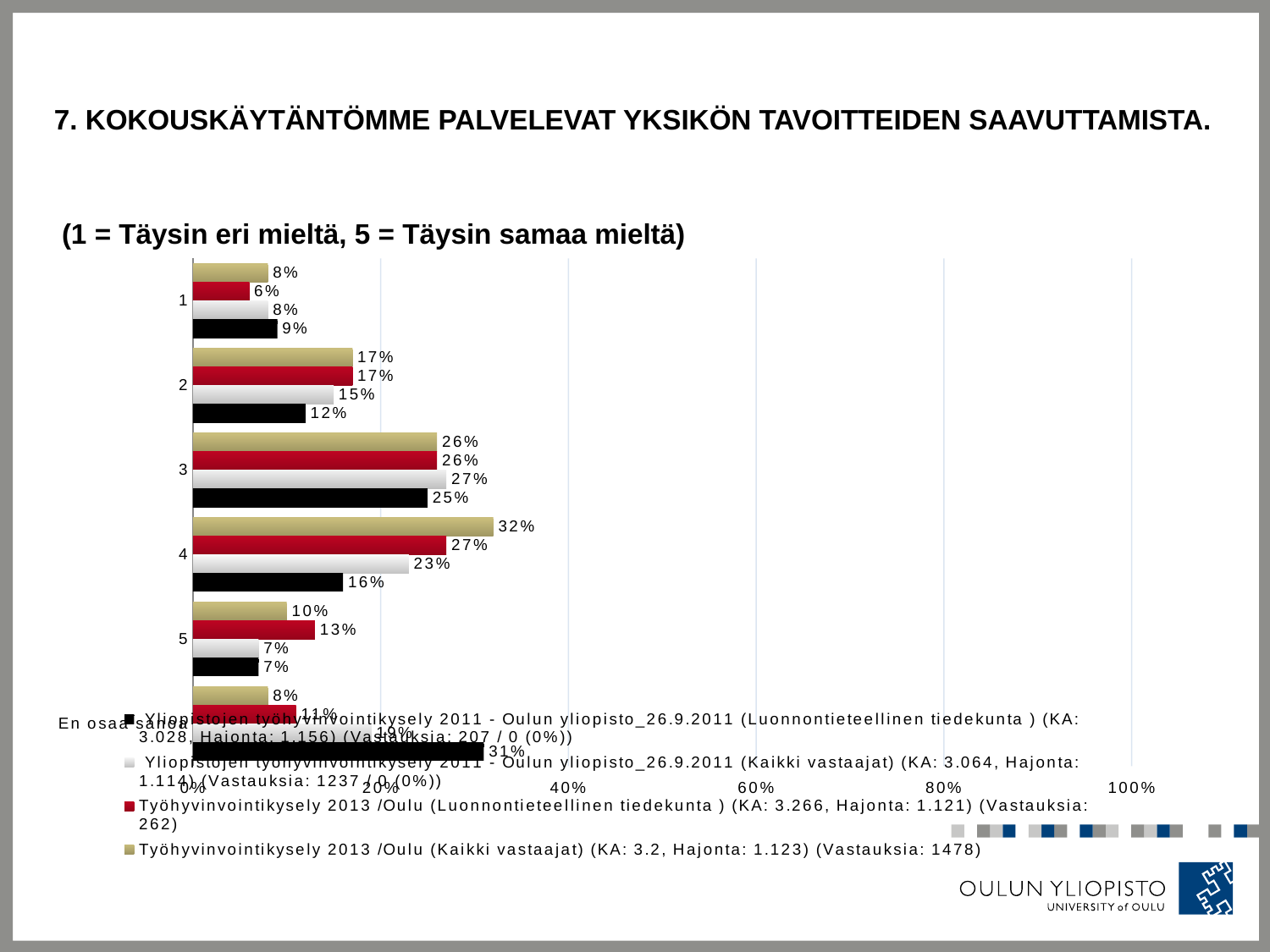
What is the value for category 4 in the Työhyvinvointikysely 2013 /Oulu (Kaikki vastaajat) series? 32% What is the value for category 5 in the Työhyvinvointikysely 2013 /Oulu (Luonnontieteellinen tiedekunta) series? 13% Is the value for category 4 in the Työhyvinvointikysely 2013 /Oulu (Kaikki vastaajat) series greater or less than 20%? greater What is the value for 'En osaa sanoa' in the Yliopistojen työhyvinvointikysely 2011 (Luonnontieteellinen tiedekunta) series? 31% What is the value for category 3 in the Yliopistojen työhyvinvointikysely 2011 (Kaikki vastaajat) series? 27% How many series does the legend list? 4 How many categories are shown on the vertical axis of the chart? 6 What kind of chart is shown on the slide? bar chart What is the difference between the Työhyvinvointikysely 2013 /Oulu (Kaikki vastaajat) value and the Yliopistojen työhyvinvointikysely 2011 (Luonnontieteellinen tiedekunta) value for category 4? 16% For 'En osaa sanoa', which is larger: the Yliopistojen työhyvinvointikysely 2011 (Kaikki vastaajat) value or the Työhyvinvointikysely 2013 /Oulu (Kaikki vastaajat) value? Yliopistojen työhyvinvointikysely 2011 (Kaikki vastaajat) Which category has the lowest value in the Työhyvinvointikysely 2013 /Oulu (Luonnontieteellinen tiedekunta) series? 1 Which category has the highest value in the Työhyvinvointikysely 2013 /Oulu (Kaikki vastaajat) series? 4